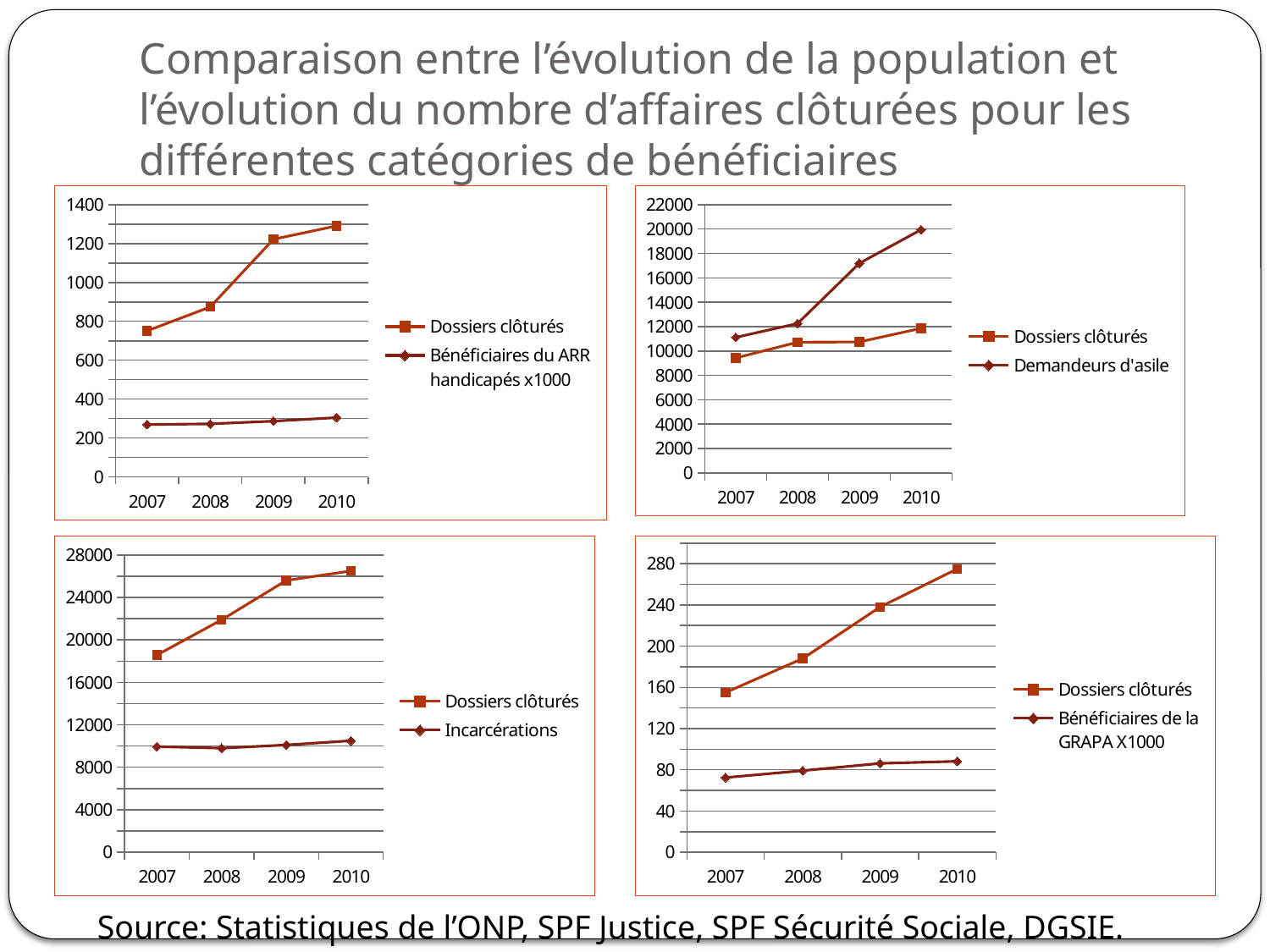
What is the second legend entry of the bottom-right chart? Bénéficiaires de la GRAPA X1000 In the top-right chart, is the value for Demandeurs d'asile in 2010 greater or less than 18000? greater How many series does the legend of the top-right chart list? 2 In the bottom-right chart, is the value for Dossiers clôturés in 2010 greater or less than 240? greater In the bottom-left chart, is the value for Dossiers clôturés in 2007 greater or less than 16000? greater In the top-right chart, which series has the larger value in 2010, Dossiers clôturés or Demandeurs d'asile? Demandeurs d'asile What kind of chart is the top-left chart on the slide? line chart In the bottom-left chart, in which year is the Dossiers clôturés series highest? 2010 In the top-left chart, does the Dossiers clôturés series rise or fall from 2007 to 2010? rise How many years are shown on the x axis of the bottom-left chart? 4